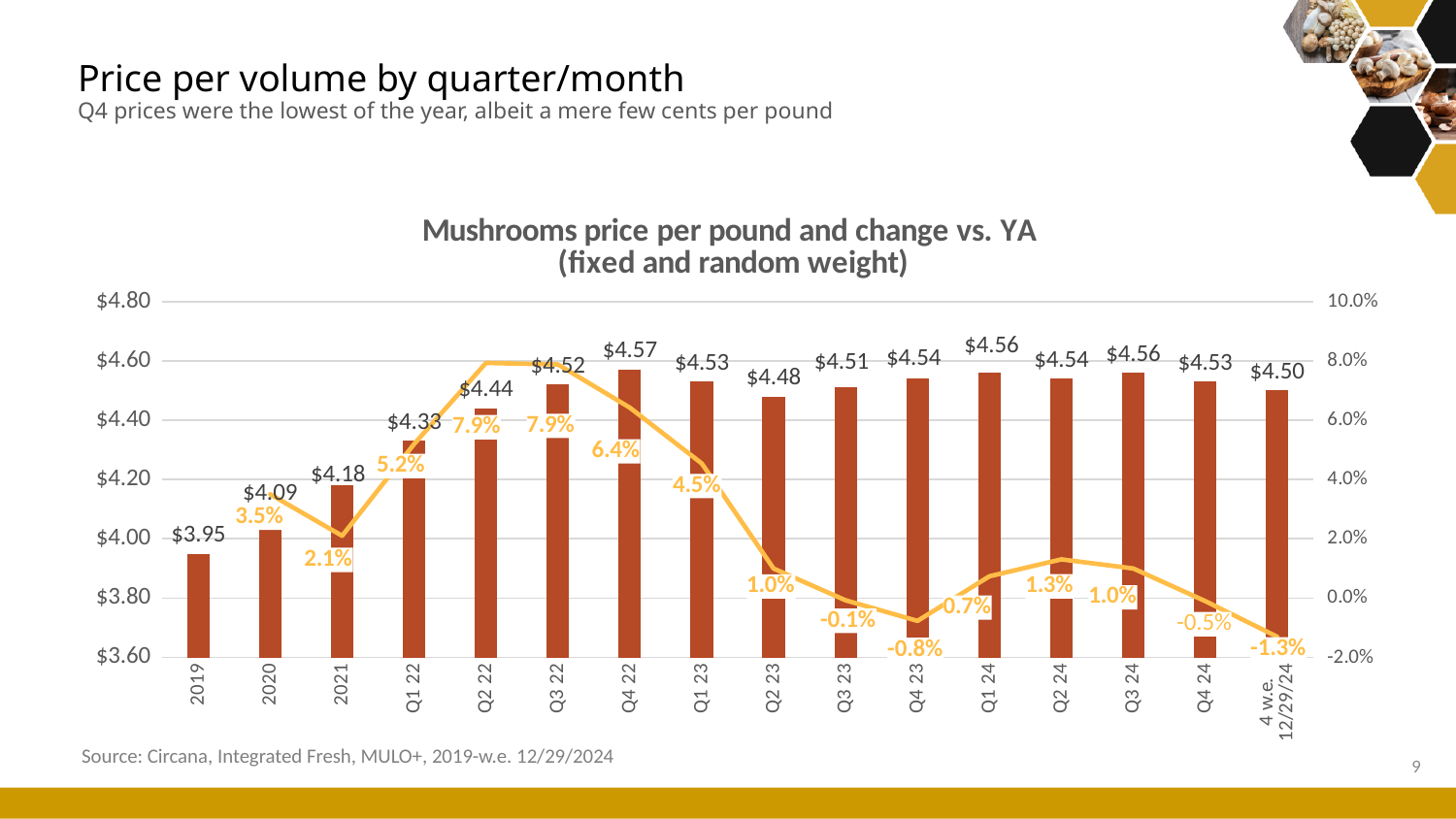
What is the mushroom price per pound for Q4 22? $4.57 Which period has the lowest change vs. YA? 4 w.e. 12/29/24 What is the difference in price per pound between Q4 22 and 2019? $0.62 Which has a higher price per pound, Q1 24 or Q4 24? Q1 24 What is the change vs. YA for the 4 w.e. 12/29/24 period? -1.3% Which period has the lowest price per pound? 2019 Which period has the highest price per pound? Q4 22 What is the title of the chart? Mushrooms price per pound and change vs. YA (fixed and random weight) What type of chart is used to show the price per pound values? Bar chart What is the change vs. YA shown for Q4 23? -0.8% What is the price per pound shown for 2019? $3.95 How many periods are shown on the x axis? 16